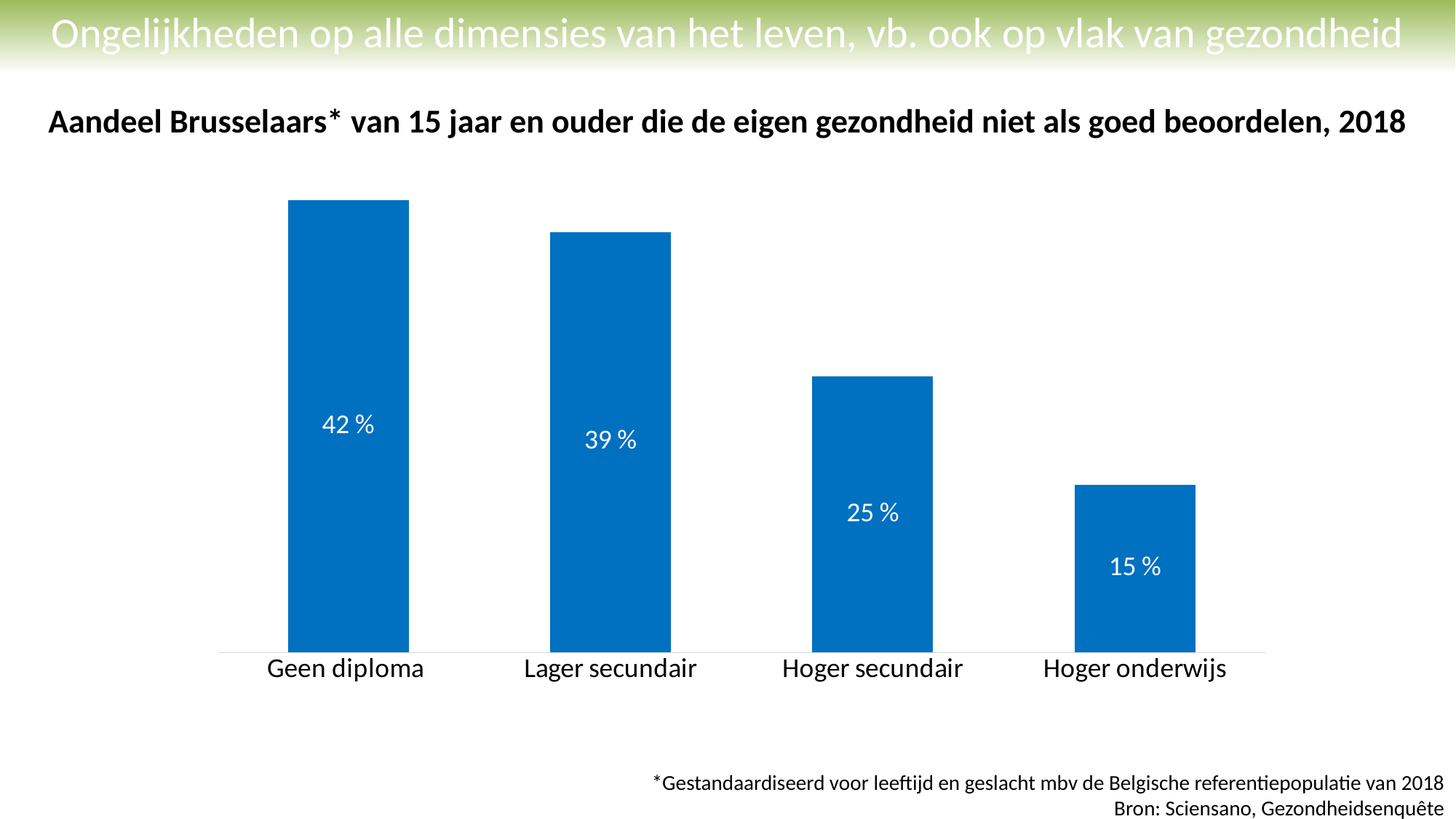
Do the values rise or fall from left to right along the x axis? Fall Which category has the highest value? Geen diploma How many categories are shown in the chart? 4 What is the value for Hoger secundair? 25 % What is the value for Lager secundair? 39 % What kind of chart is shown on the slide? Bar chart What is the difference between the values for Geen diploma and Hoger onderwijs? 27 % What is the value for Geen diploma? 42 % Which category has the lowest value? Hoger onderwijs What is the difference between the values for Lager secundair and Hoger secundair? 14 % Which is larger, the value for Hoger secundair or the value for Hoger onderwijs? Hoger secundair What is the value for Hoger onderwijs? 15 %